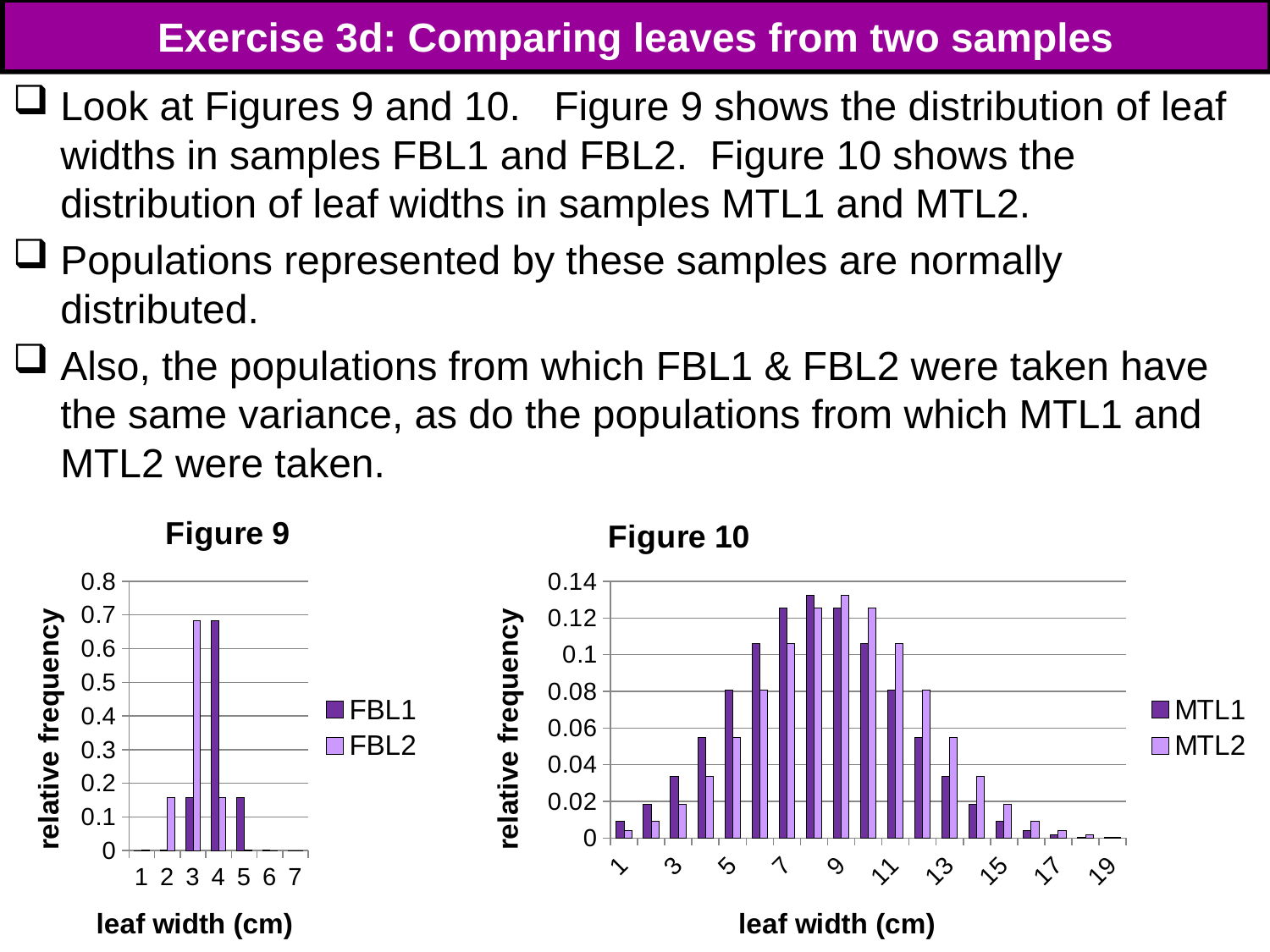
In Figure 9, at which leaf width is the FBL1 relative frequency highest? 4 In Figure 10, is the MTL2 value at leaf width 15 greater or less than 0.04? less What is the y-axis label of Figure 10? relative frequency In Figure 10, is the MTL1 value at leaf width 5 greater or less than 0.06? greater In Figure 9, at which leaf width is the FBL2 relative frequency highest? 3 In Figure 10, at which leaf width is the MTL2 relative frequency highest? 9 How many series does the legend of Figure 10 list? 2 In Figure 9, is the FBL1 value at leaf width 4 greater or less than 0.6? greater In Figure 9, at leaf width 3, which series has the larger relative frequency, FBL1 or FBL2? FBL2 In Figure 10, at leaf width 5, which series has the larger relative frequency, MTL1 or MTL2? MTL1 What kind of chart is Figure 9? bar chart